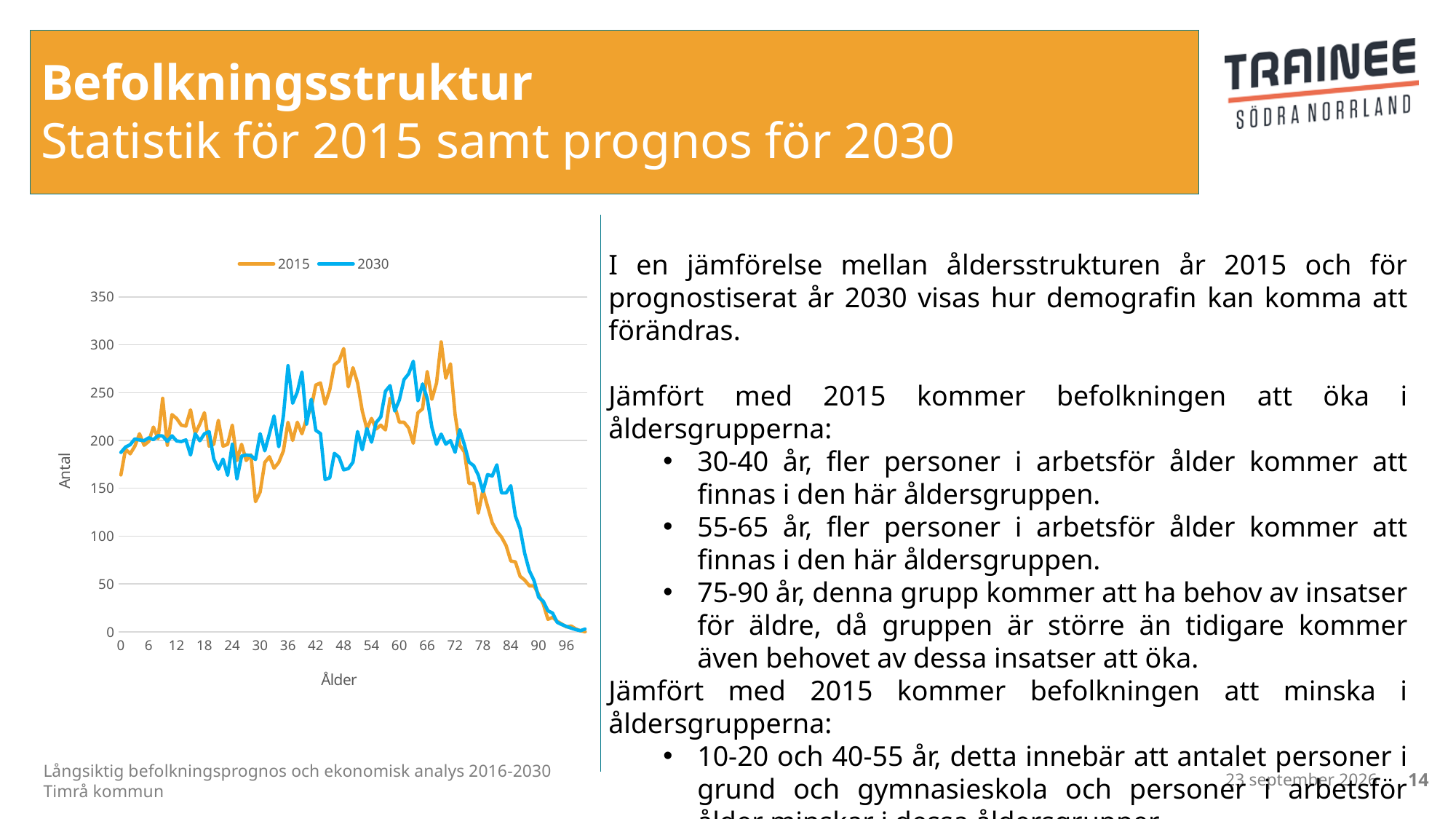
Is the value of the 2030 series at age 84 greater or less than 100? greater Which two series are listed in the chart legend? 2015 and 2030 Is the value of the 2015 series at age 48 greater or less than 250? greater What kind of chart is shown on the slide? Line chart At age 36, which series has the larger value, 2015 or 2030? 2030 Do the values of both series rise or fall along the x axis from age 72 to age 96? Fall What is the title of the chart's horizontal axis? Ålder At age 48, which series has the larger value, 2015 or 2030? 2015 How many series does the chart legend list? 2 Is the value of the 2015 series at age 84 greater or less than 100? less